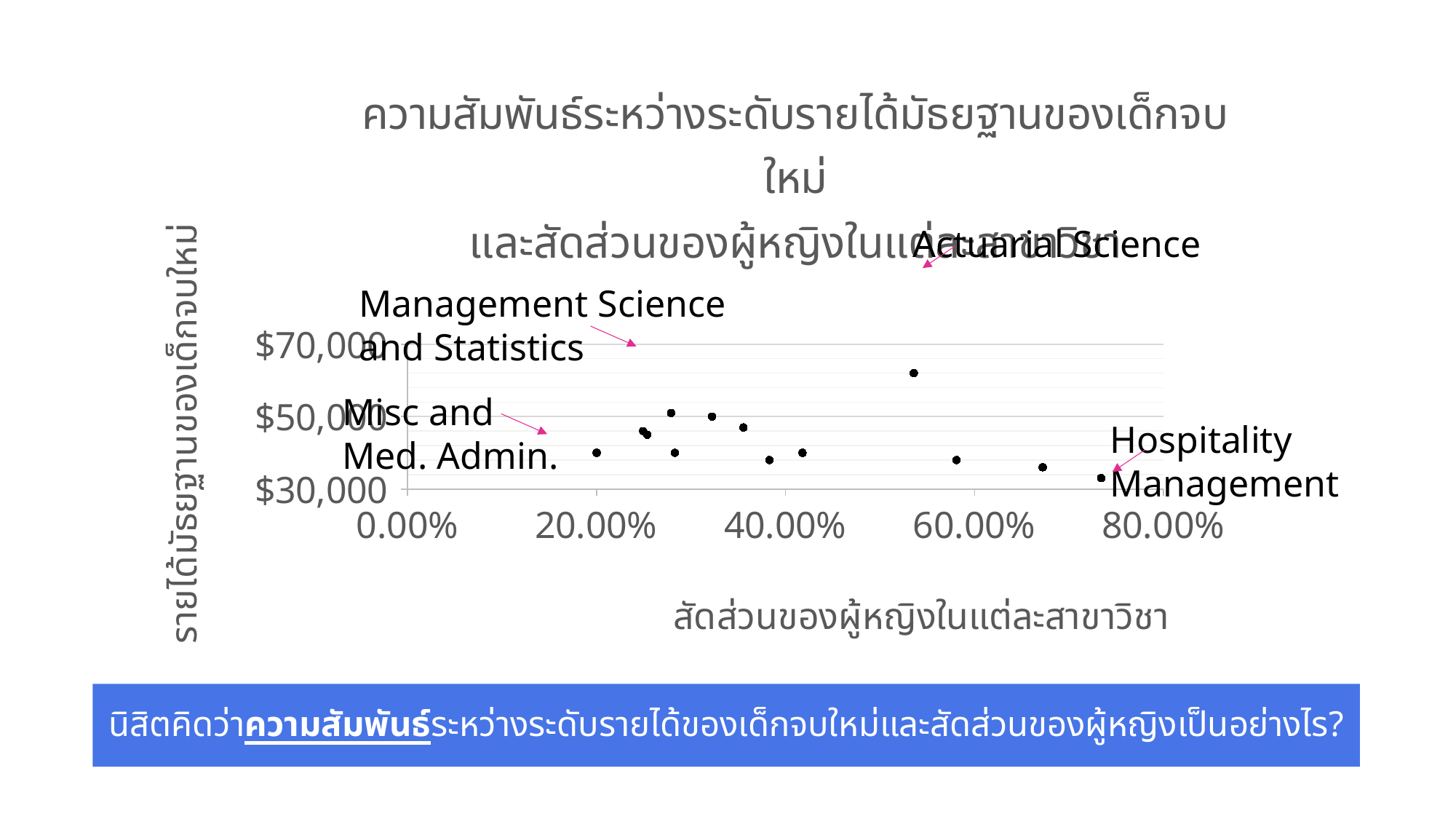
Is the median income for Actuarial Science greater or less than $50,000? greater Is the median income for Management Science and Statistics greater or less than $70,000? less What kind of chart is shown on the slide? scatter chart Is the share of women for Actuarial Science greater or less than 40.00%? greater Among the labelled points, which has the lowest median income? Hospitality Management Among the labelled points, which has the highest median income? Actuarial Science What is the highest tick label shown on the x axis? 80.00% Which has the higher share of women, Hospitality Management or Management Science and Statistics? Hospitality Management Which has the higher median income, Actuarial Science or Hospitality Management? Actuarial Science